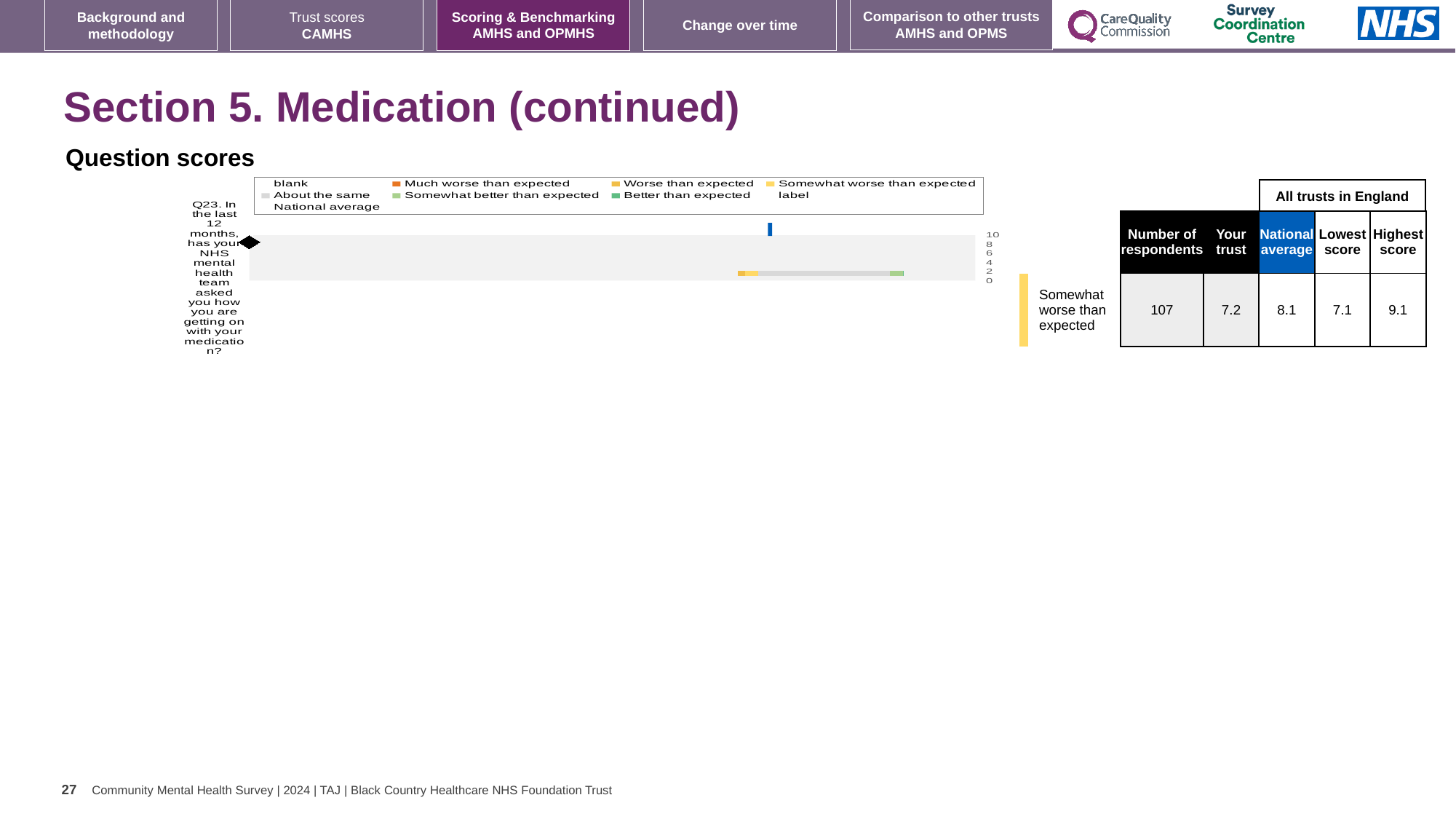
How many respondents answered Q23? 107 Which is larger for Q23: the 'Your trust' score or the national average? National average What is the highest score among all trusts in England for Q23? 9.1 What is the lowest score among all trusts in England for Q23? 7.1 What is the difference between the highest score and the lowest score for Q23? 2.0 What kind of chart is shown on the slide? Bar chart What is the 'Your trust' score for Q23 about being asked how you are getting on with your medication? 7.2 What is the national average score for Q23? 8.1 By how much does the national average exceed the 'Your trust' score for Q23? 0.9 How many entries does the chart legend list? 9 Which benchmark category is the trust's Q23 score assigned to? Somewhat worse than expected How many questions (categories) are plotted in the chart? 1